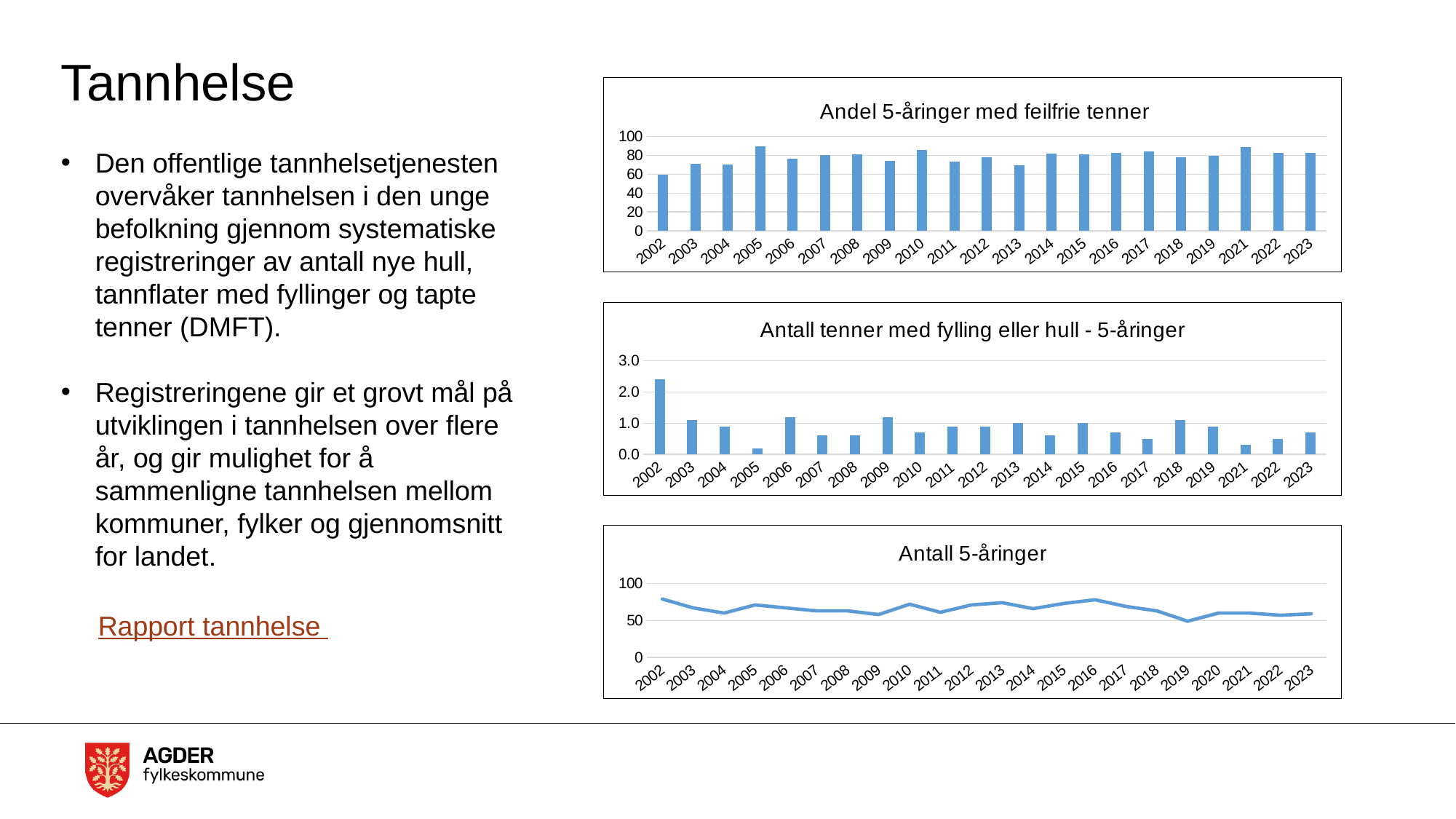
In the chart "Antall tenner med fylling eller hull - 5-åringer", is the value for 2002 greater or less than 2.0? greater In the chart "Antall tenner med fylling eller hull - 5-åringer", which year has the highest value? 2002 In the chart "Andel 5-åringer med feilfrie tenner", is the value for 2013 greater or less than 80? less In the chart "Andel 5-åringer med feilfrie tenner", which year has the lowest value? 2002 What type of chart is "Andel 5-åringer med feilfrie tenner"? bar chart In the chart "Andel 5-åringer med feilfrie tenner", is the value for 2005 greater or less than 80? greater In the chart "Antall tenner med fylling eller hull - 5-åringer", which year has the lowest value? 2005 How many bars are shown in the chart "Antall tenner med fylling eller hull - 5-åringer"? 21 In the chart "Andel 5-åringer med feilfrie tenner", which is larger, the value for 2002 or the value for 2005? 2005 What type of chart is "Antall 5-åringer"? line chart In the chart "Antall 5-åringer", which year has the lowest value? 2019